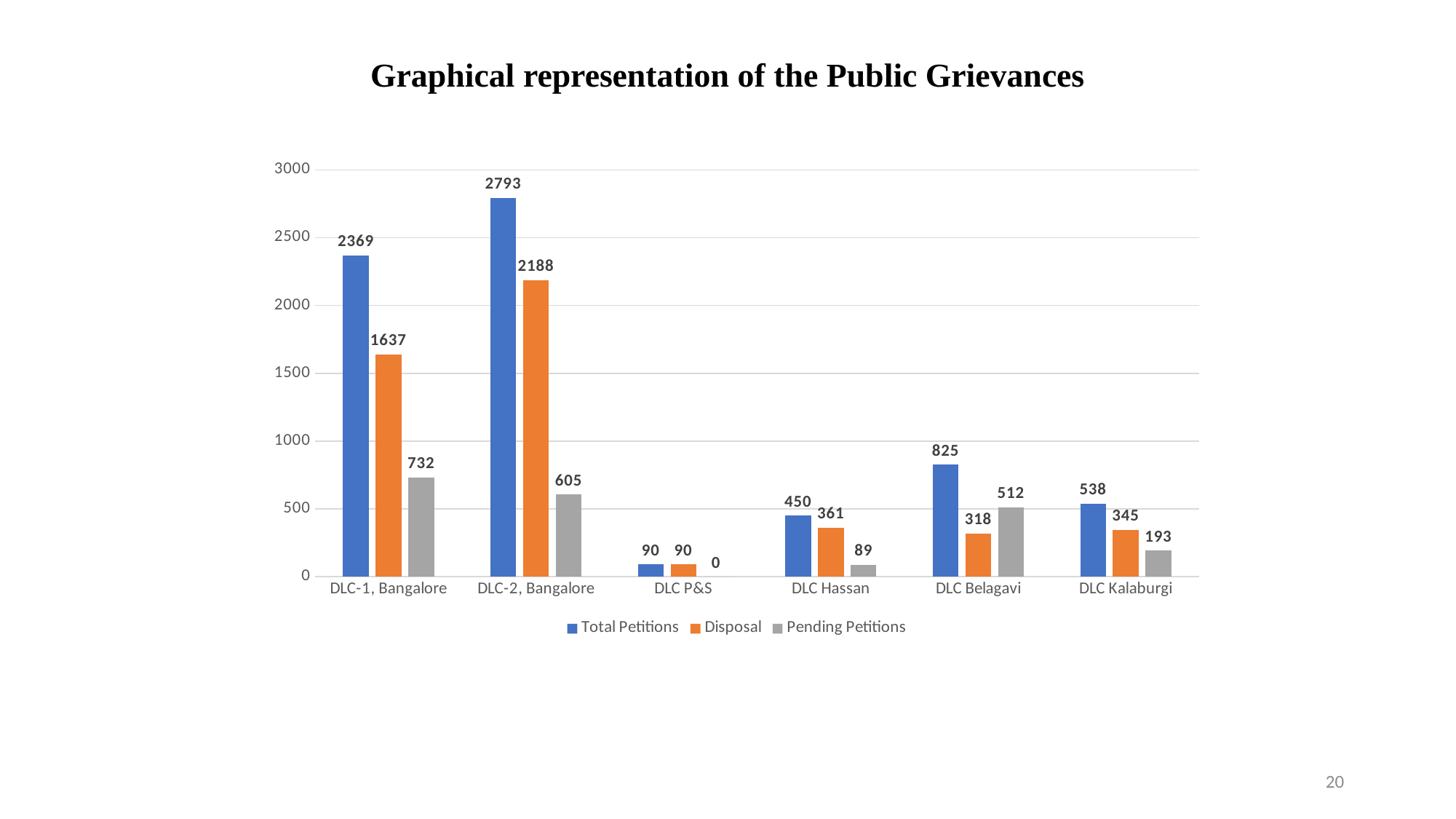
What is the value of Total Petitions for DLC-2, Bangalore? 2793 Which category has the highest Total Petitions? DLC-2, Bangalore Which is larger for DLC Hassan: Disposal or Pending Petitions? Disposal What is the Pending Petitions value for DLC Kalaburgi? 193 How many series does the legend list? 3 What is the difference between Total Petitions and Disposal for DLC Belagavi? 507 What is the Disposal value for DLC-1, Bangalore? 1637 What kind of chart is shown on the slide? Bar chart Is the Total Petitions value for DLC Kalaburgi greater or less than 500? greater Which category has the lowest Pending Petitions? DLC P&S What is the title of the chart? Graphical representation of the Public Grievances How many categories are shown on the x axis? 6